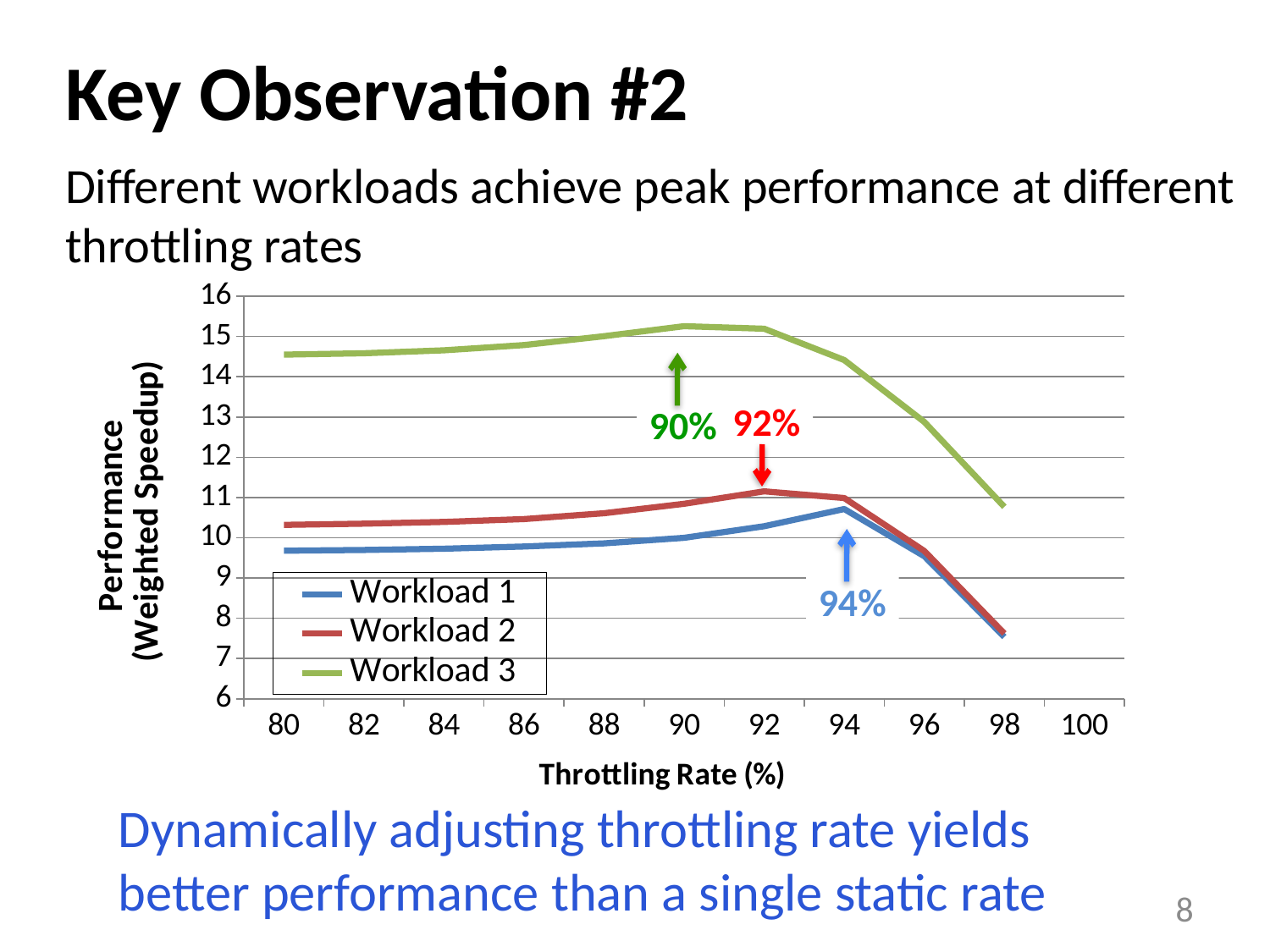
What is the title of the x axis? Throttling Rate (%) Which workload has the highest performance across the throttling rates shown? Workload 3 What kind of chart is shown on the slide? Line chart What are the series names listed in the legend? Workload 1, Workload 2, Workload 3 At which throttling rate does Workload 1 reach its peak performance, according to the annotation? 94% How many series does the legend list? 3 Is the value for Workload 3 at a throttling rate of 80 greater or less than 14? greater At which throttling rate does Workload 3 reach its peak performance, according to the annotation? 90% Does the performance of Workload 3 rise or fall as the throttling rate increases from 92 to 98? Fall At a throttling rate of 80, which is larger: Workload 2 or Workload 1? Workload 2 At which throttling rate does Workload 2 reach its peak performance, according to the annotation? 92% Is the value for Workload 1 at a throttling rate of 80 greater or less than 10? less